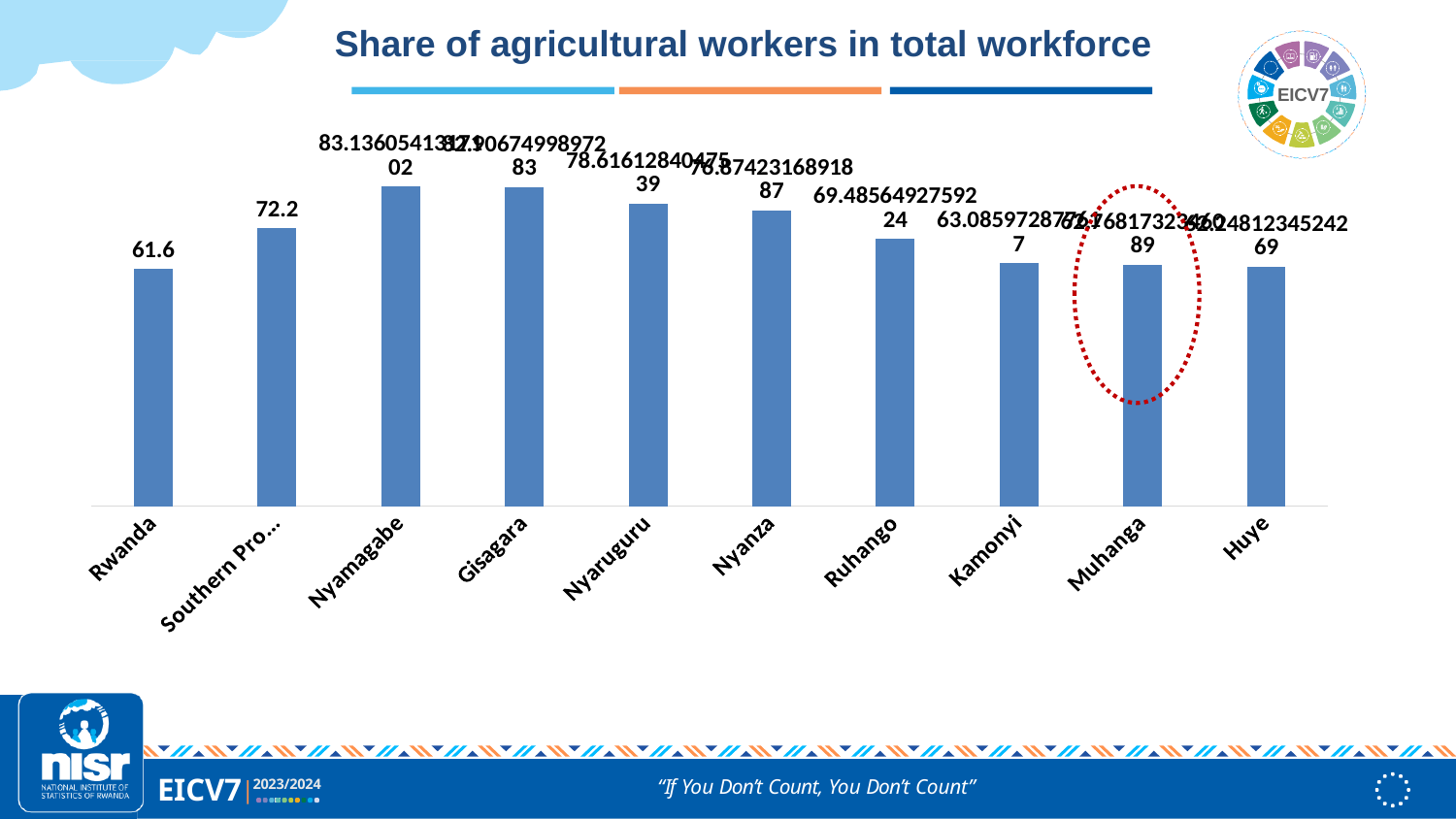
Which category's bar is highlighted with a red dotted circle? Muhanga How many categories are shown on the x axis? 10 What is the difference between the values for Southern Pro... and Rwanda? 10.6 What is the value for Rwanda? 61.6 Which is larger, the value for Nyamagabe or the value for Rwanda? Nyamagabe Which is larger, the value for Southern Pro... or the value for Huye? Southern Pro... What is the title of the chart? Share of agricultural workers in total workforce What kind of chart is shown on the slide? Bar chart What is the value for Southern Pro...? 72.2 Which is larger, the value for Nyaruguru or the value for Kamonyi? Nyaruguru